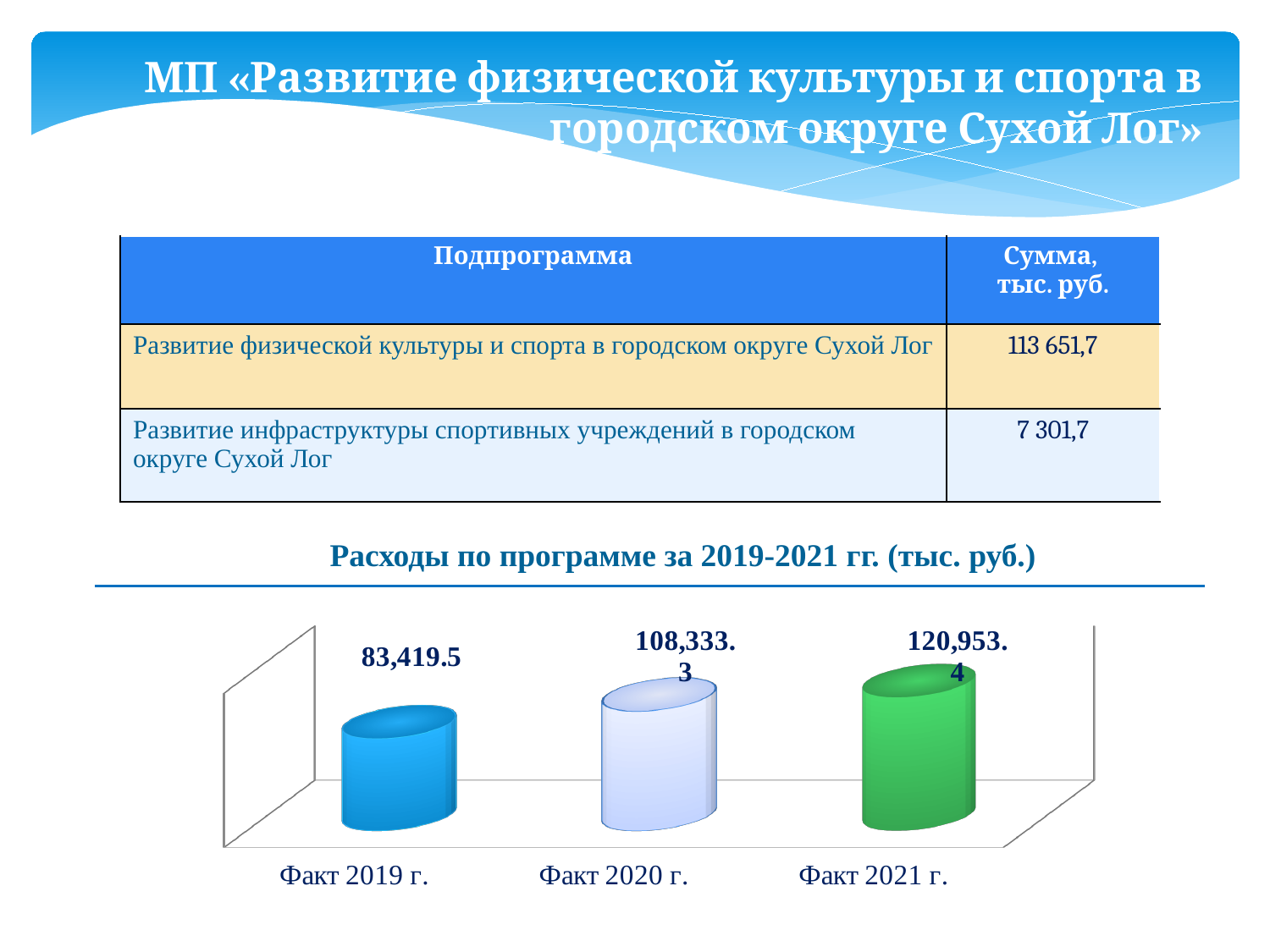
What is the value for Факт 2020 г. in the chart? 108,333.3 Which category has the lowest value in the chart? Факт 2019 г. Do the values rise or fall from Факт 2019 г. to Факт 2021 г.? Rise How many categories are shown in the chart? 3 What is the difference between the values for Факт 2021 г. and Факт 2019 г.? 37,533.9 What kind of chart is shown on the slide? Bar chart Which category has the highest value in the chart? Факт 2021 г. What is the value for Факт 2019 г. in the chart? 83,419.5 Which is larger, the value for Факт 2020 г. or the value for Факт 2019 г.? Факт 2020 г. What is the difference between the values for Факт 2021 г. and Факт 2020 г.? 12,620.1 What is the value for Факт 2021 г. in the chart? 120,953.4 What is the difference between the values for Факт 2020 г. and Факт 2019 г.? 24,913.8